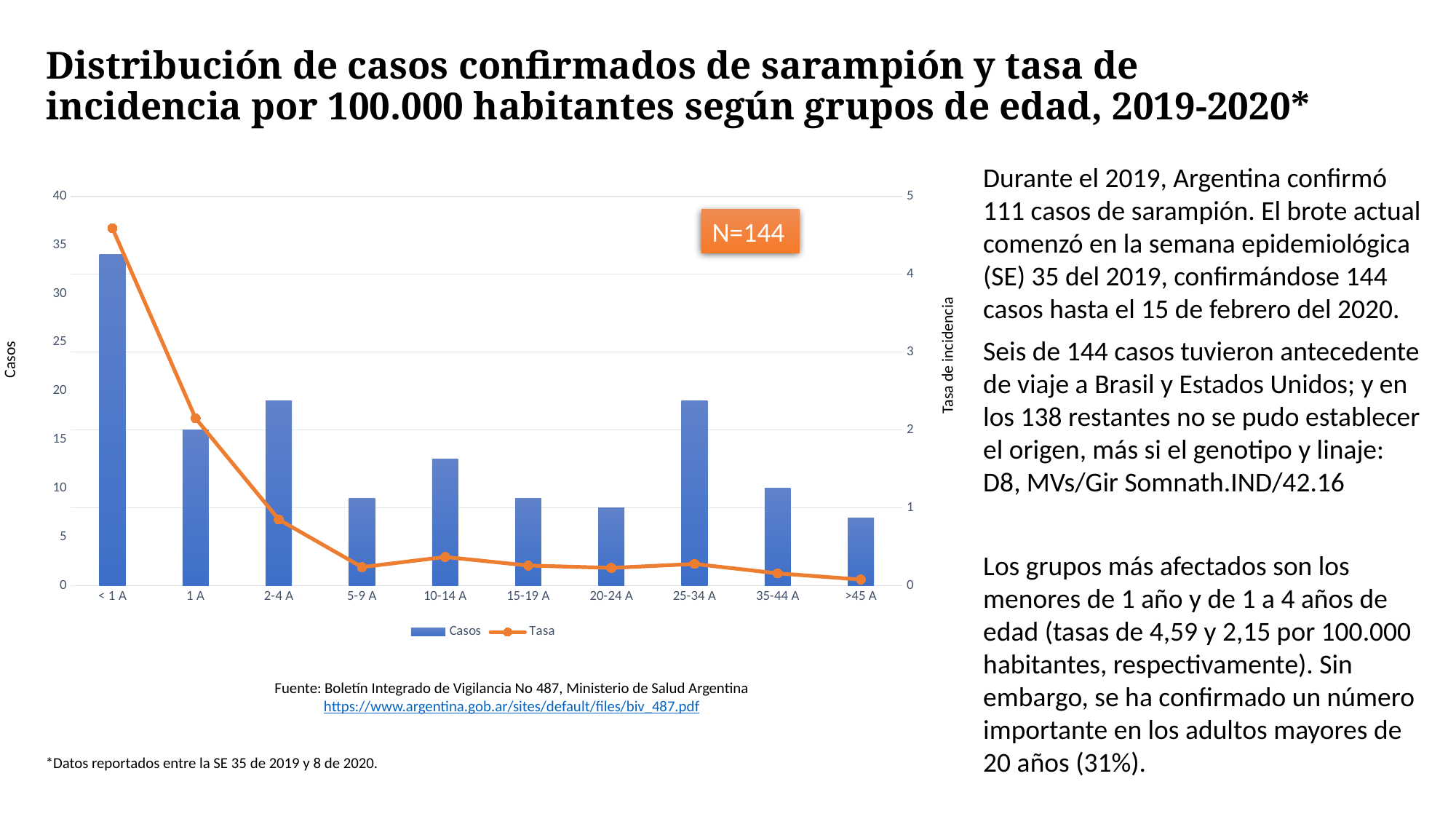
What kind of chart is used to show the Casos series? bar chart Which age group has the highest number of Casos? < 1 A What value of N is shown in the orange box on the chart? N=144 Does the Tasa line generally rise or fall from < 1 A to >45 A? fall Which age group has the highest Tasa value? < 1 A How many age-group categories are shown on the x axis of the chart? 10 Is the Tasa value for 2-4 A greater or less than 1? less Is the Tasa value for < 1 A greater or less than 4? greater How many series does the chart legend list? 2 Is the Casos value for 5-9 A greater or less than 10? less Which has more Casos, 10-14 A or 5-9 A? 10-14 A